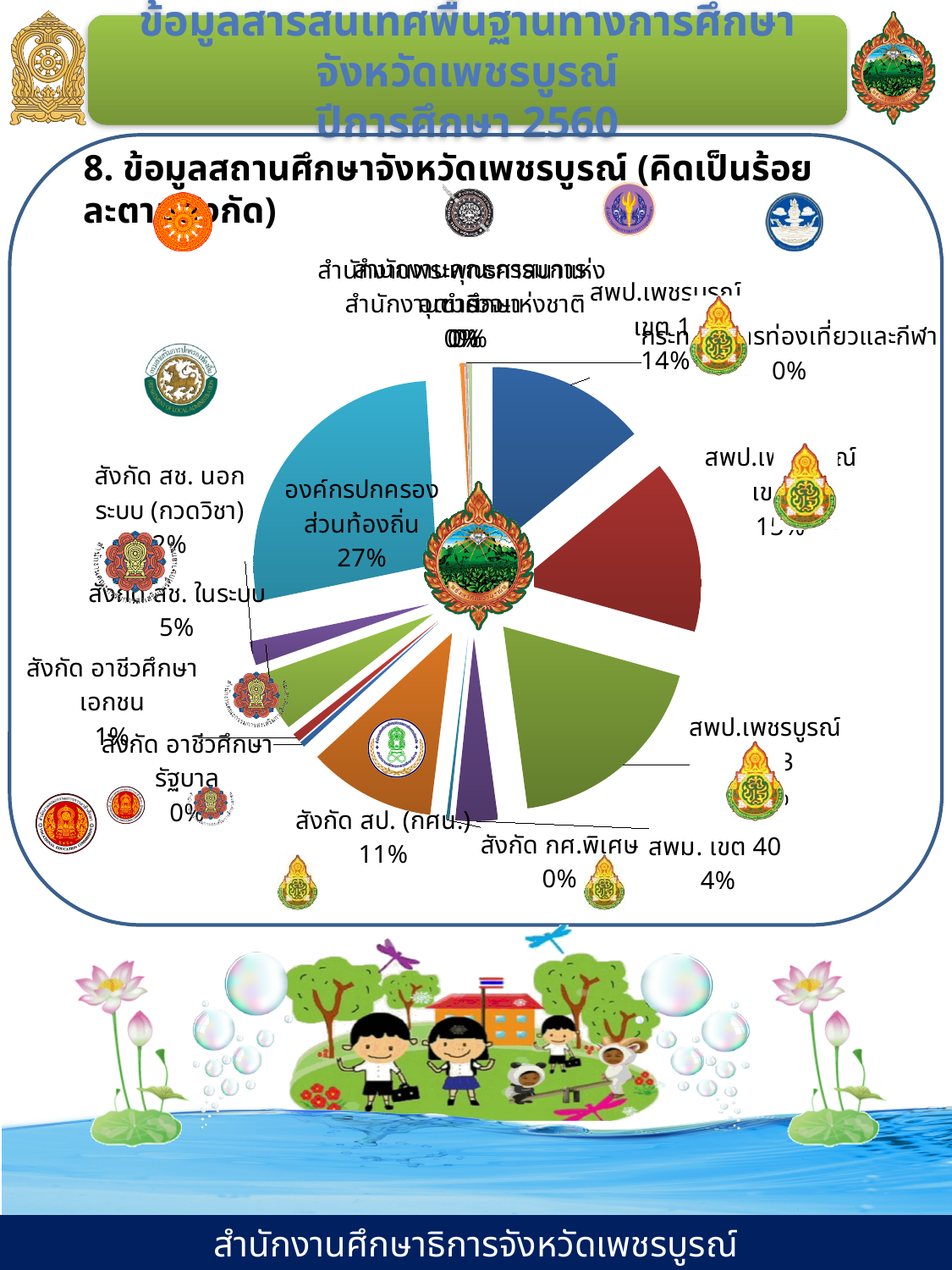
What percentage is shown for องค์กรปกครองส่วนท้องถิ่น? 27% Which category has the largest share of the pie? องค์กรปกครองส่วนท้องถิ่น How many percentage points larger is the share for สังกัด สป. (กศน.) than the share for สพม. เขต 40? 7 percentage points What percentage is shown for กระทรวงการท่องเที่ยวและกีฬา? 0% Which is larger, the share for สพป.เพชรบูรณ์ เขต 1 or the share for สังกัด สป. (กศน.)? สพป.เพชรบูรณ์ เขต 1 What kind of chart is shown on the slide? Pie chart What percentage is shown for สพป.เพชรบูรณ์ เขต 1? 14% What percentage is shown for สังกัด อาชีวศึกษา เอกชน? 1% What percentage is shown for สังกัด สป. (กศน.)? 11% What percentage is shown for สพม. เขต 40? 4% How many percentage points larger is the share for องค์กรปกครองส่วนท้องถิ่น than the share for สพป.เพชรบูรณ์ เขต 1? 13 percentage points What percentage is shown for สังกัด สช. ในระบบ? 5%